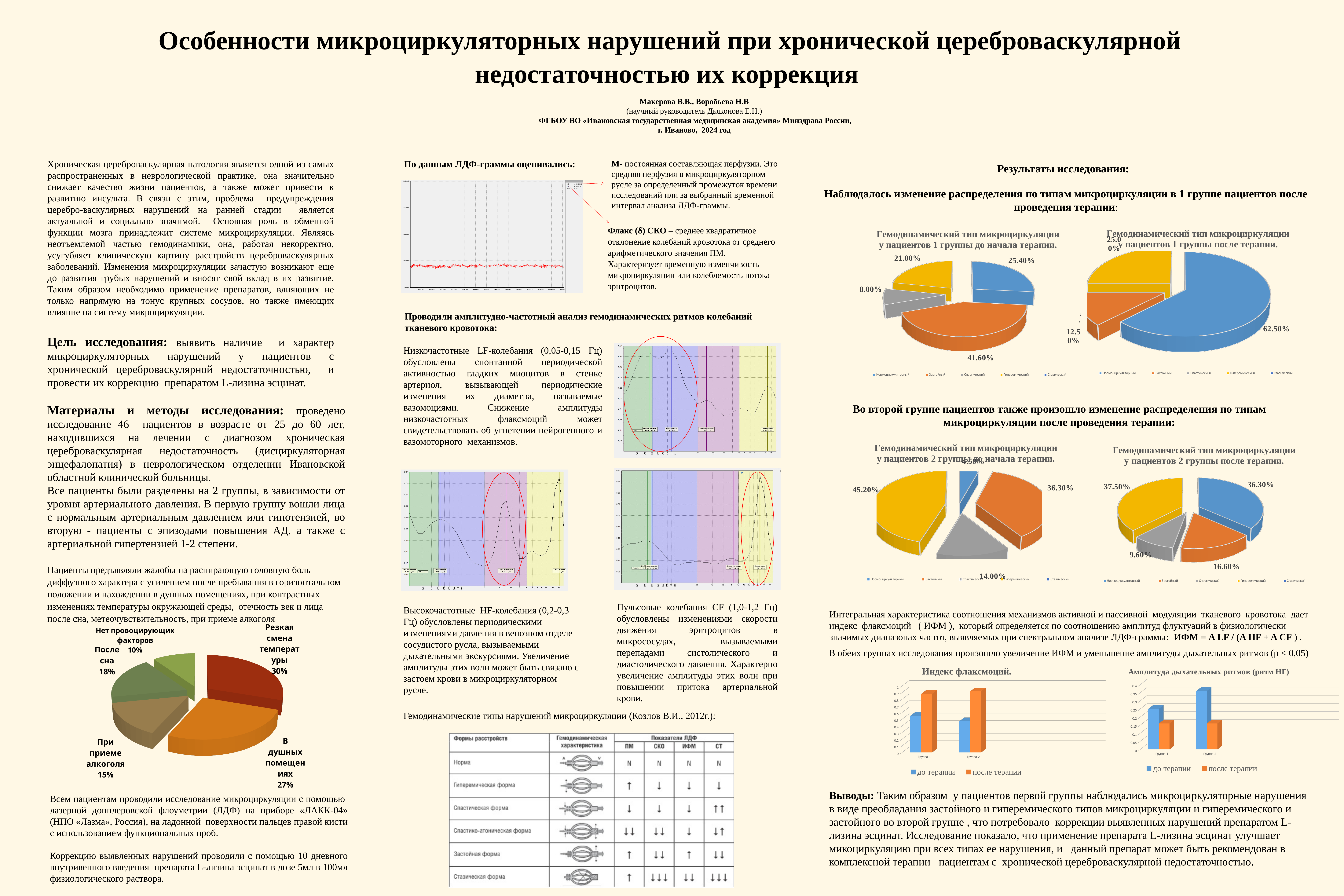
In the pie chart of patient complaints at the bottom left, how many slices are there? 5 In the pie chart of patient complaints at the bottom left, what is the difference between the shares for 'В душных помещениях' and 'При приеме алкоголя'? 12% In the bar chart 'Амплитуда дыхательных ритмов (ритм HF)', which is larger for Группа 2: 'до терапии' or 'после терапии'? до терапии In the pie chart 'Гемодинамический тип микроциркуляции у пациентов 2 группы после терапии', what is the difference between the largest share (37.50%) and the share of 16.60%? 20.90% In the pie chart of patient complaints at the bottom left, what share is labelled 'Резкая смена температуры'? 30% In the bar chart 'Индекс флаксмоций', is the value for Группа 1 'после терапии' greater or less than 0.8? greater In the pie chart 'Гемодинамический тип микроциркуляции у пациентов 1 группы до начала терапии', what is the smallest share shown? 8.00% In the pie chart 'Гемодинамический тип микроциркуляции у пациентов 1 группы после терапии', what is the largest share shown? 62.50% In the pie chart 'Гемодинамический тип микроциркуляции у пациентов 1 группы до начала терапии', what is the largest share shown? 41.60% In the bar chart 'Индекс флаксмоций', how many series does the legend list? 2 In the pie chart 'Гемодинамический тип микроциркуляции у пациентов 2 группы после терапии', what is the smallest share shown? 9.60% In the pie chart of patient complaints at the bottom left, which category has the smallest share? Нет провоцирующих факторов